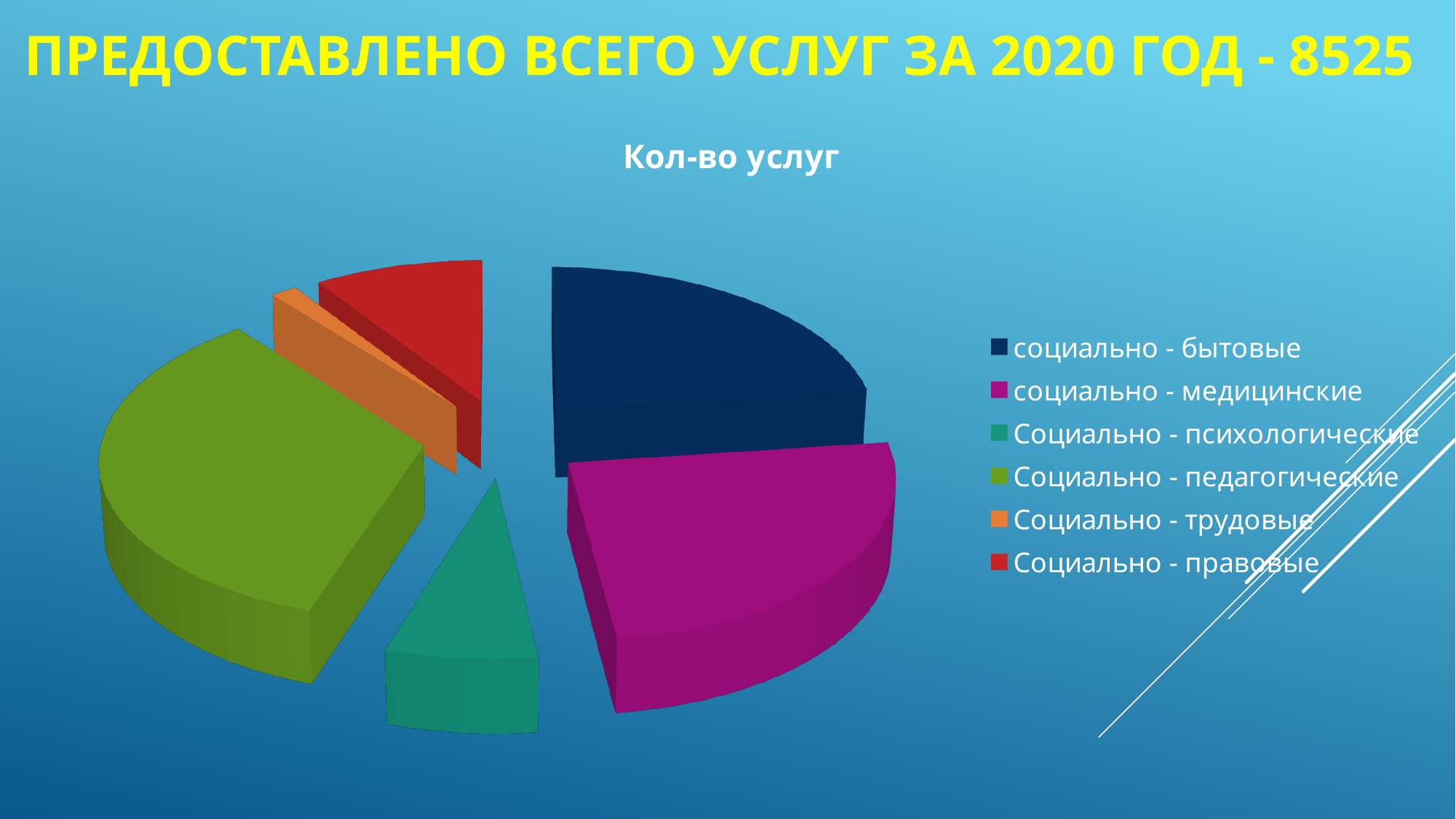
Which slice is larger: Социально - правовые or Социально - трудовые? Социально - правовые What kind of chart is shown on the slide? pie chart Which category has the smallest slice in the pie chart? Социально - трудовые Which slice is larger: социально - бытовые or Социально - трудовые? социально - бытовые Which category has the largest slice in the pie chart? Социально - педагогические Which slice is larger: социально - медицинские or Социально - правовые? социально - медицинские How many categories does the pie chart show? 6 Which category is shown in green in the pie chart? Социально - педагогические What is the title of the pie chart? Кол-во услуг